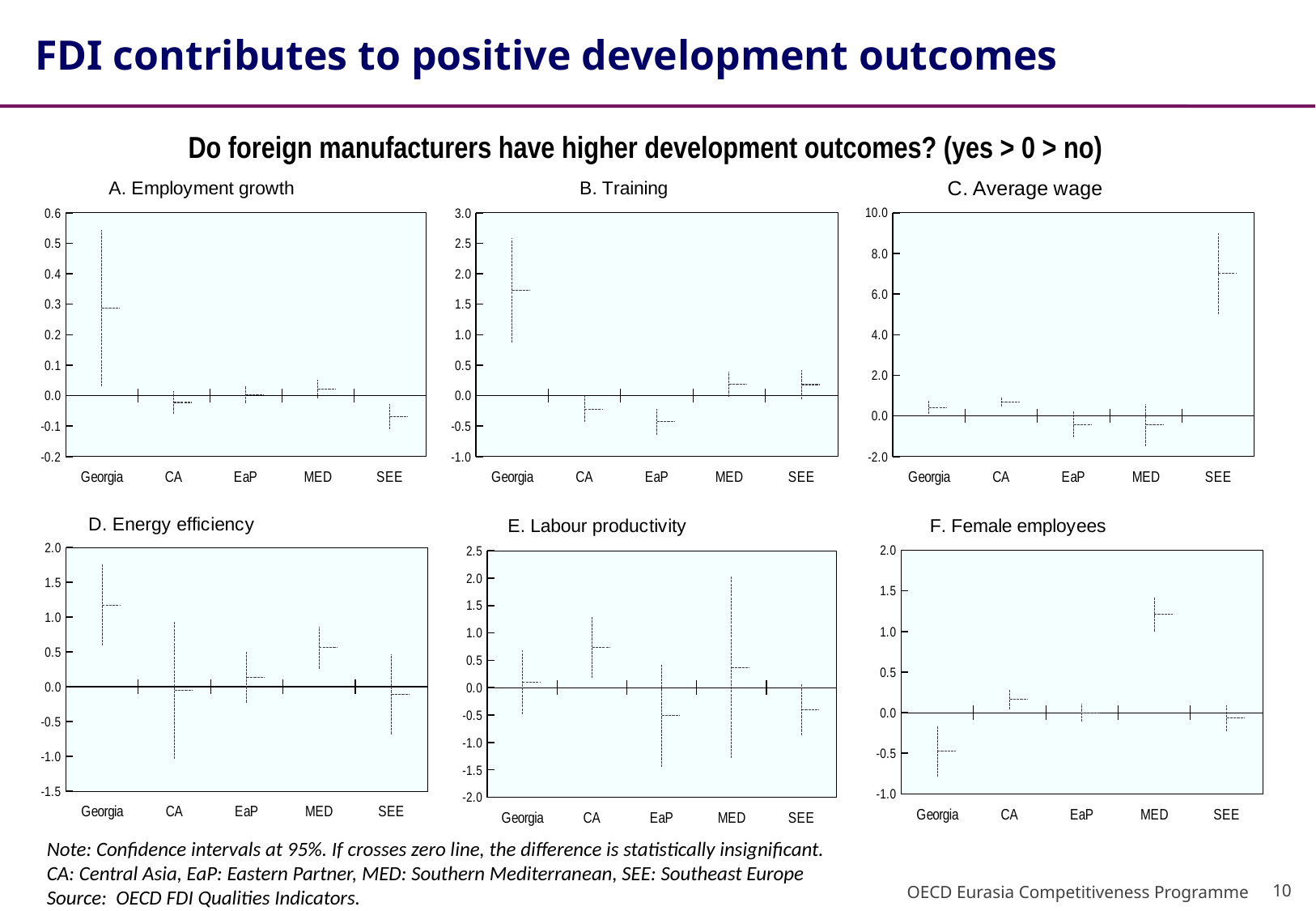
In chart B (Training), is the point estimate for Georgia greater or less than 1.0? greater In chart D (Energy efficiency), which is larger, the point estimate for Georgia or for MED? Georgia In chart F (Female employees), which region has the lowest point estimate? Georgia According to the note on the slide, at what level are the confidence intervals set? 95% In chart A (Employment growth), which region has the highest point estimate? Georgia In chart A (Employment growth), is the point estimate for Georgia greater or less than 0.2? greater In chart E (Labour productivity), which region has the highest point estimate? CA How many charts are shown on the slide? 6 In chart C (Average wage), which region has the highest point estimate? SEE In chart A (Employment growth), how many regions are plotted along the x axis? 5 In chart F (Female employees), is the point estimate for MED greater or less than 1.0? greater